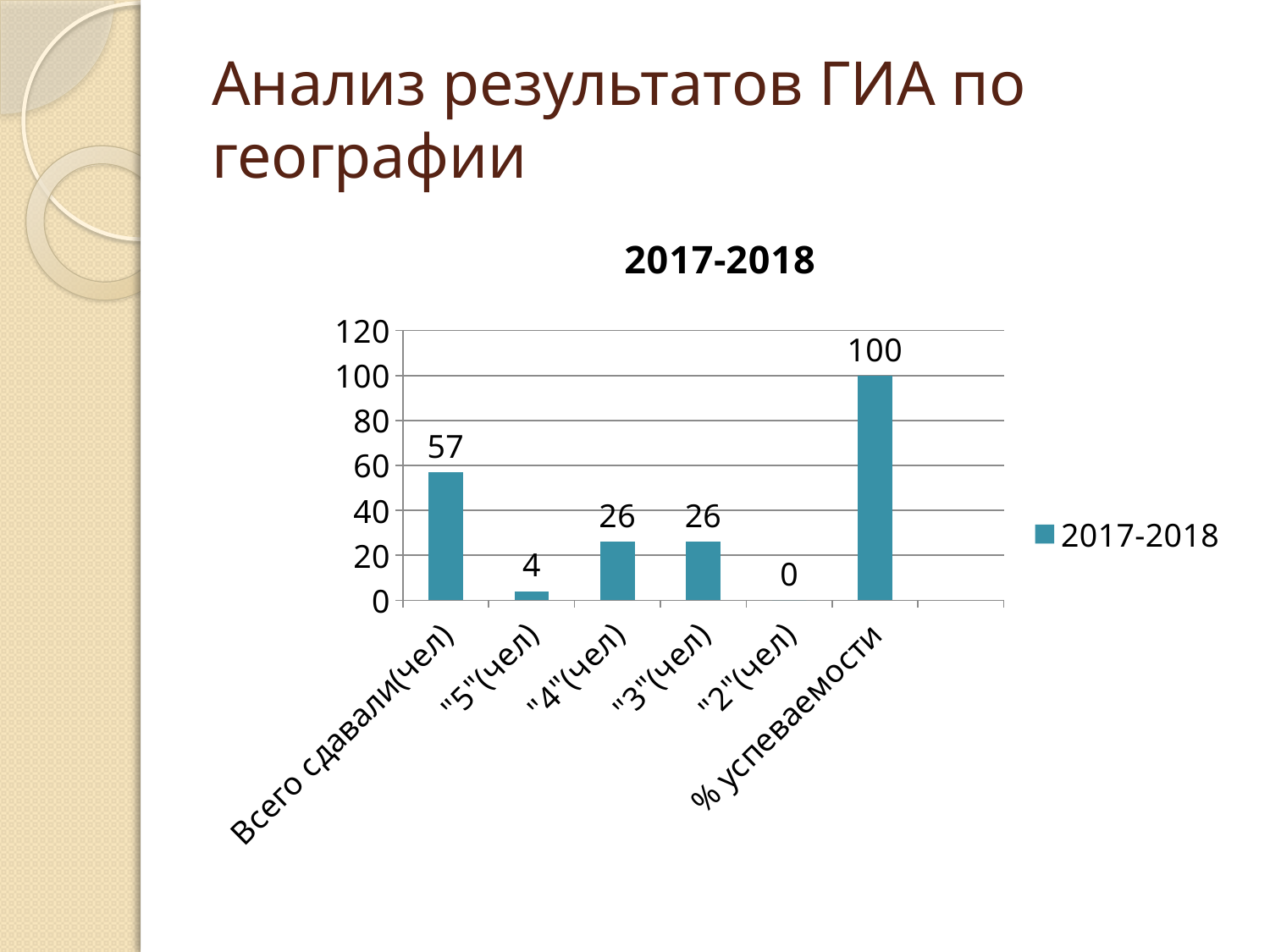
How many categories are shown on the x axis? 6 What is the value for "2"(чел)? 0 What kind of chart is this? bar chart What is the value for "% успеваемости"? 100 What is the value for "Всего сдавали(чел)"? 57 What is the title of the chart? 2017-2018 What is the value for "4"(чел)? 26 What is the value for "5"(чел)? 4 Which category has the highest value? % успеваемости Which category has the lowest value? "2"(чел) Which is larger, the value for "5"(чел) or the value for "3"(чел)? "3"(чел) What is the difference between the values for "Всего сдавали(чел)" and "4"(чел)? 31